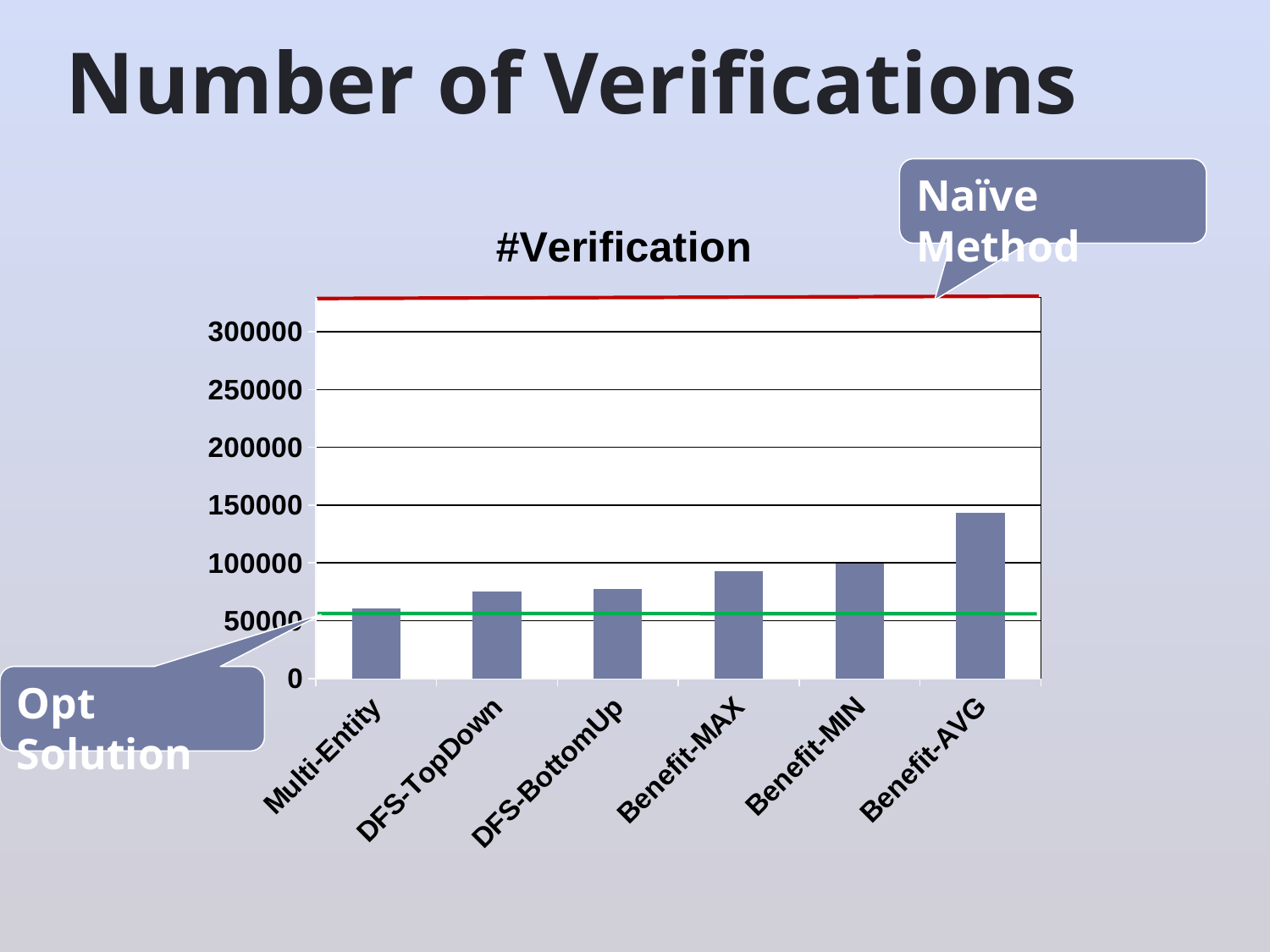
How many categories are shown on the x axis of the chart? 6 What kind of chart is shown on the slide? bar chart Do the bar values rise or fall from left to right along the x axis? rise Which category has the highest number of verifications? Benefit-AVG Which category has the lowest number of verifications? Multi-Entity What is the title of the chart? #Verification Is the value for Multi-Entity greater or less than 100000? less Is the value for Benefit-AVG greater or less than 100000? greater What does the red horizontal line at the top of the chart represent, according to the callout? Naïve Method Is the value for DFS-TopDown greater or less than 50000? greater Which is larger, the value for Benefit-MAX or the value for DFS-TopDown? Benefit-MAX